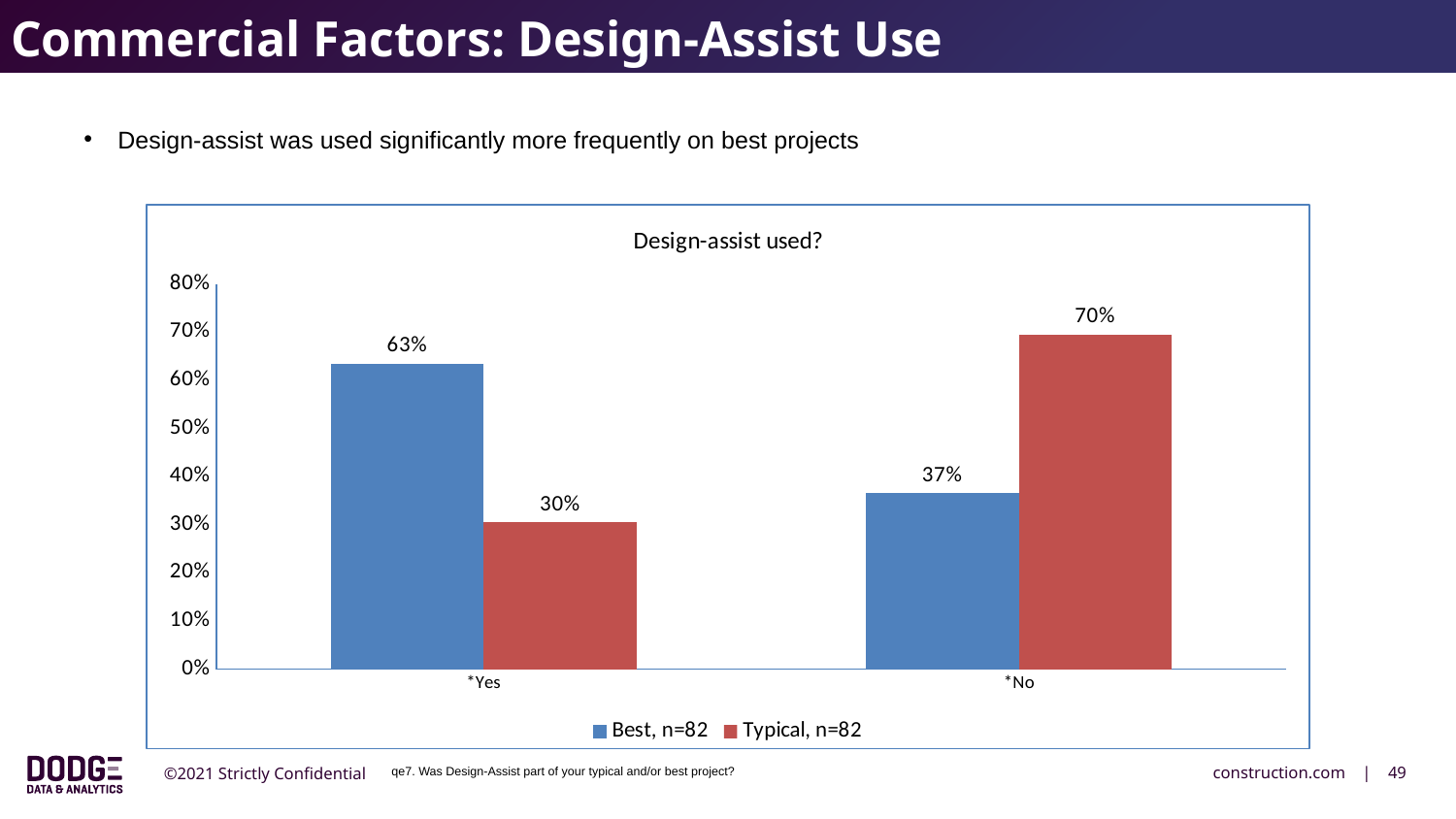
What is the value for Best, n=82 in the *Yes category? 63% Which is larger in the *No category, Best, n=82 or Typical, n=82? Typical, n=82 What is the value for Typical, n=82 in the *No category? 70% What is the value for Typical, n=82 in the *Yes category? 30% Which bar has the highest value on the chart? Typical, n=82 in *No What kind of chart is shown? Bar chart How many series does the legend list? 2 Which bar has the lowest value on the chart? Typical, n=82 in *Yes How many categories are shown on the x axis? 2 What is the value for Best, n=82 in the *No category? 37% What is the difference between the Best, n=82 and Typical, n=82 values in the *Yes category? 33% What is the title of the chart? Design-assist used?